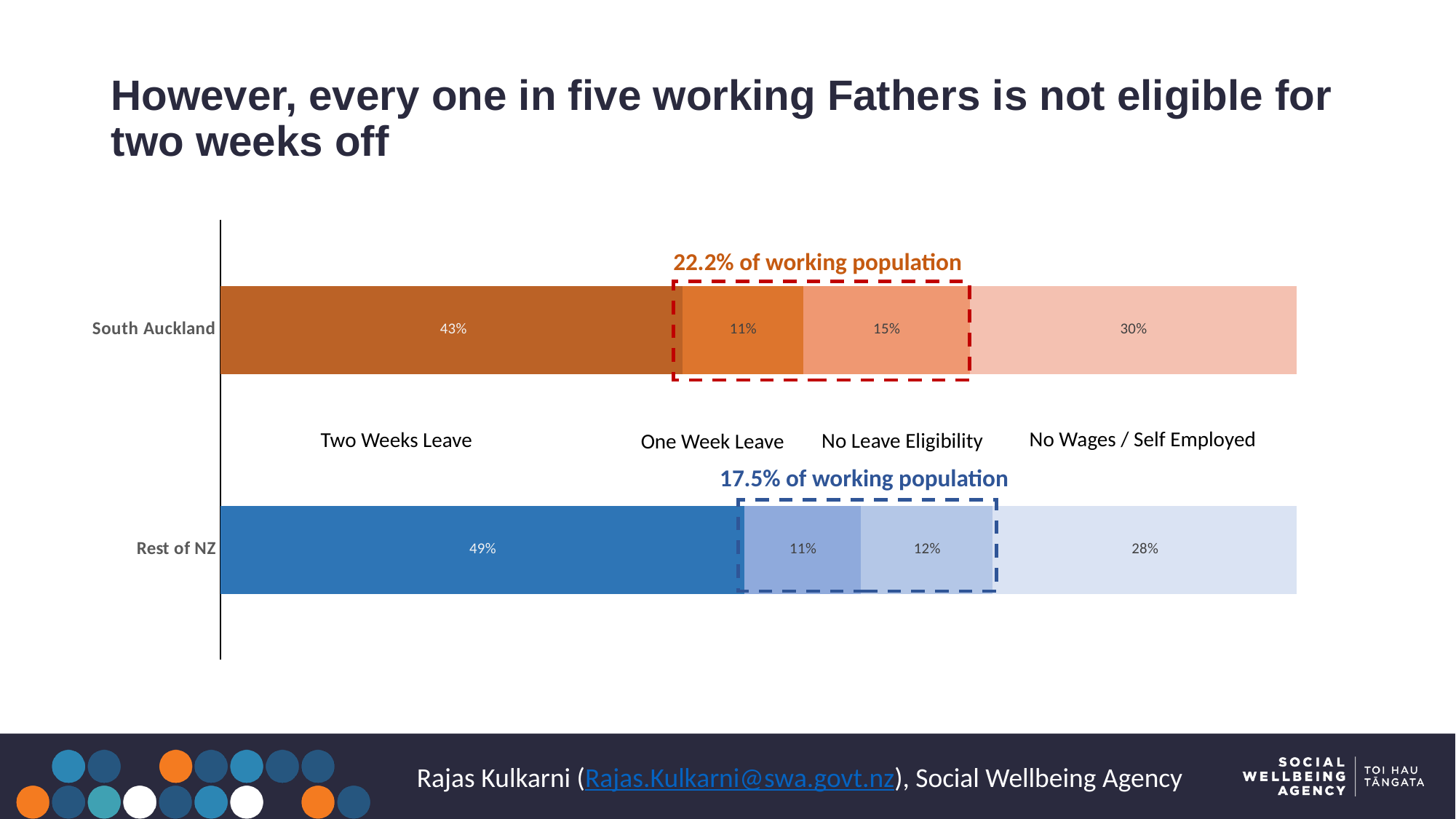
What is the No Leave Eligibility value for South Auckland? 15% What is the No Wages / Self Employed value for Rest of NZ? 28% Which region has the larger No Leave Eligibility share, South Auckland or Rest of NZ? South Auckland What kind of chart is shown on the slide? Stacked bar chart What is the difference between the Two Weeks Leave values for Rest of NZ and South Auckland? 6% What percentage of South Auckland working fathers have Two Weeks Leave? 43% How many regions (bars) are shown in the chart? 2 According to the annotation, what share of the working population in South Auckland is covered by the dashed red box? 22.2% of working population Which segment is the smallest in the Rest of NZ bar? One Week Leave What percentage of Rest of NZ working fathers have Two Weeks Leave? 49% Which segment is the largest in the South Auckland bar? Two Weeks Leave What is the One Week Leave value for Rest of NZ? 11%